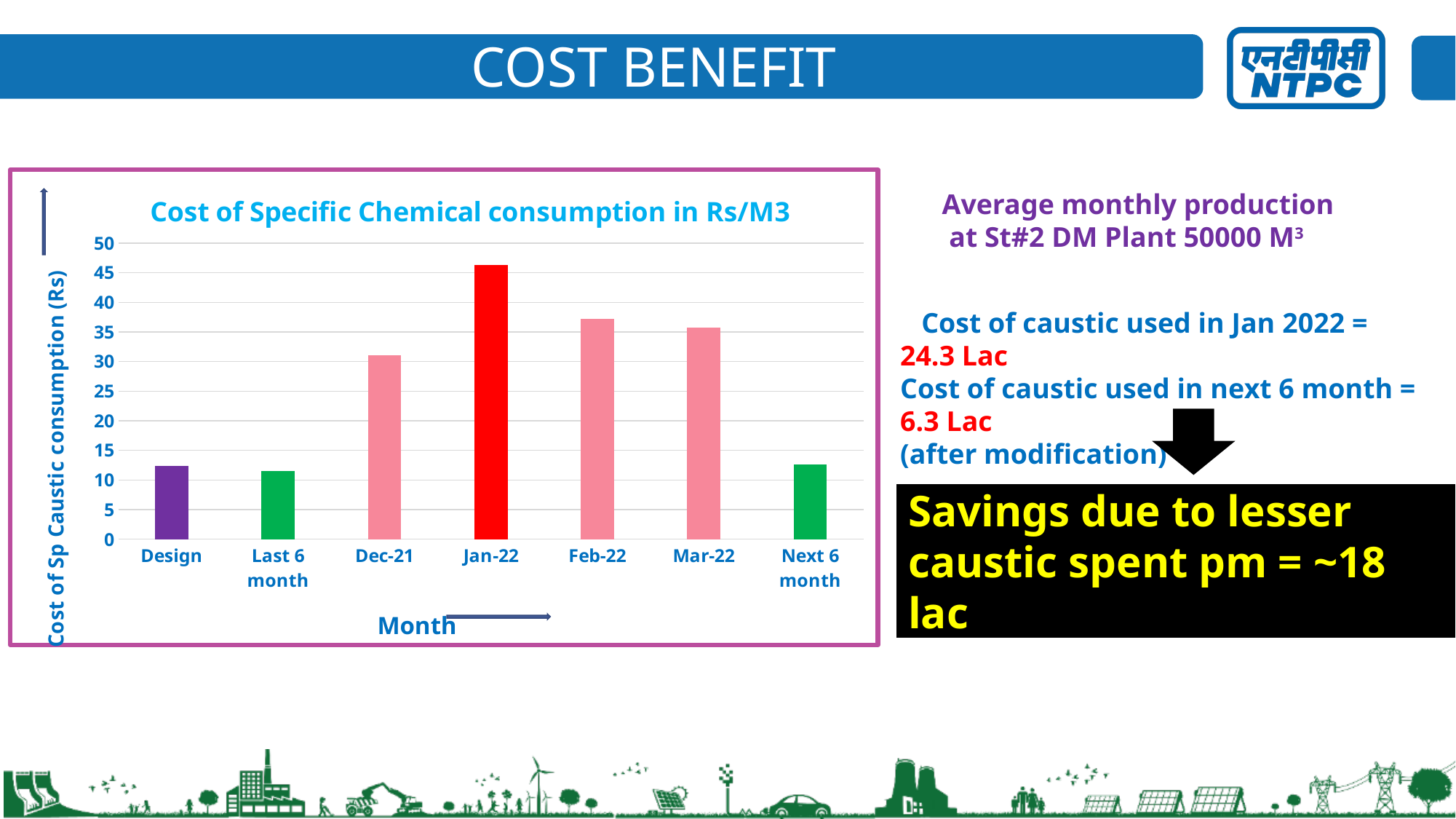
Which is larger, the value for Dec-21 or the value for Last 6 month? Dec-21 Is the value for Feb-22 greater or less than 40? less Is the value for Jan-22 greater or less than 45? greater Which category has the highest bar in the chart? Jan-22 Is the value for Dec-21 greater or less than 30? greater What kind of chart is shown on the slide? bar chart What is the title of the chart? Cost of Specific Chemical consumption in Rs/M3 Which is larger, the value for Jan-22 or the value for Feb-22? Jan-22 How many categories are shown on the x axis of the chart? 7 What is the label of the x axis of the chart? Month